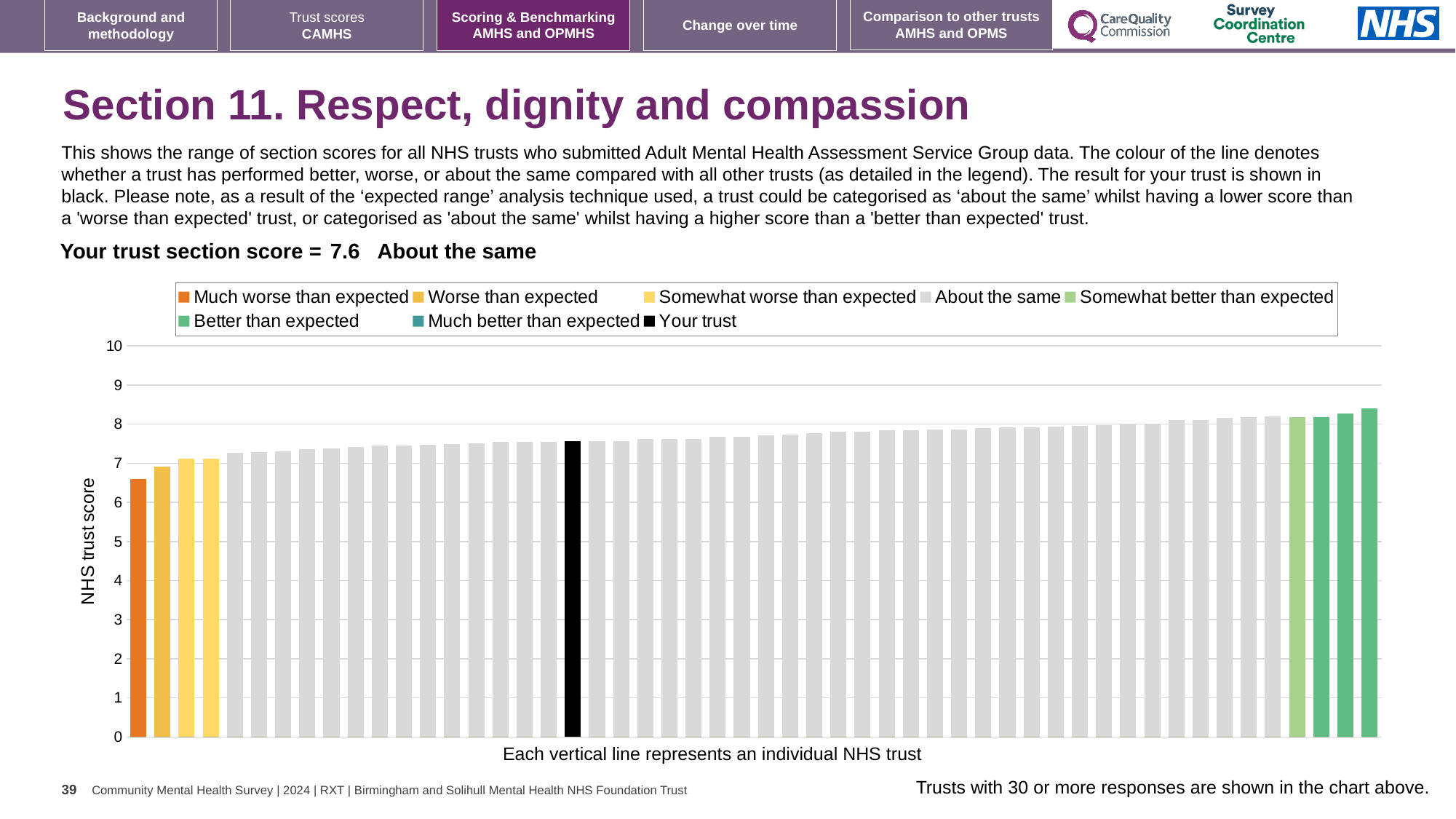
Is the value of the lowest bar in the chart greater or less than 7? less What is the label on the vertical axis of the chart? NHS trust score Is the value of the black 'Your trust' bar greater or less than 8? less Is the value of the black 'Your trust' bar greater or less than 7? greater How many entries does the chart legend list? 8 Which legend category does the lowest bar in the chart belong to? Much worse than expected What kind of chart is shown on the slide? bar chart Which legend category does the highest bar in the chart belong to? Better than expected What is the section score for your trust shown on the slide? 7.6 How many bars in the chart are coloured as 'Much worse than expected'? 1 Do the bar values rise or fall from left to right across the chart? rise